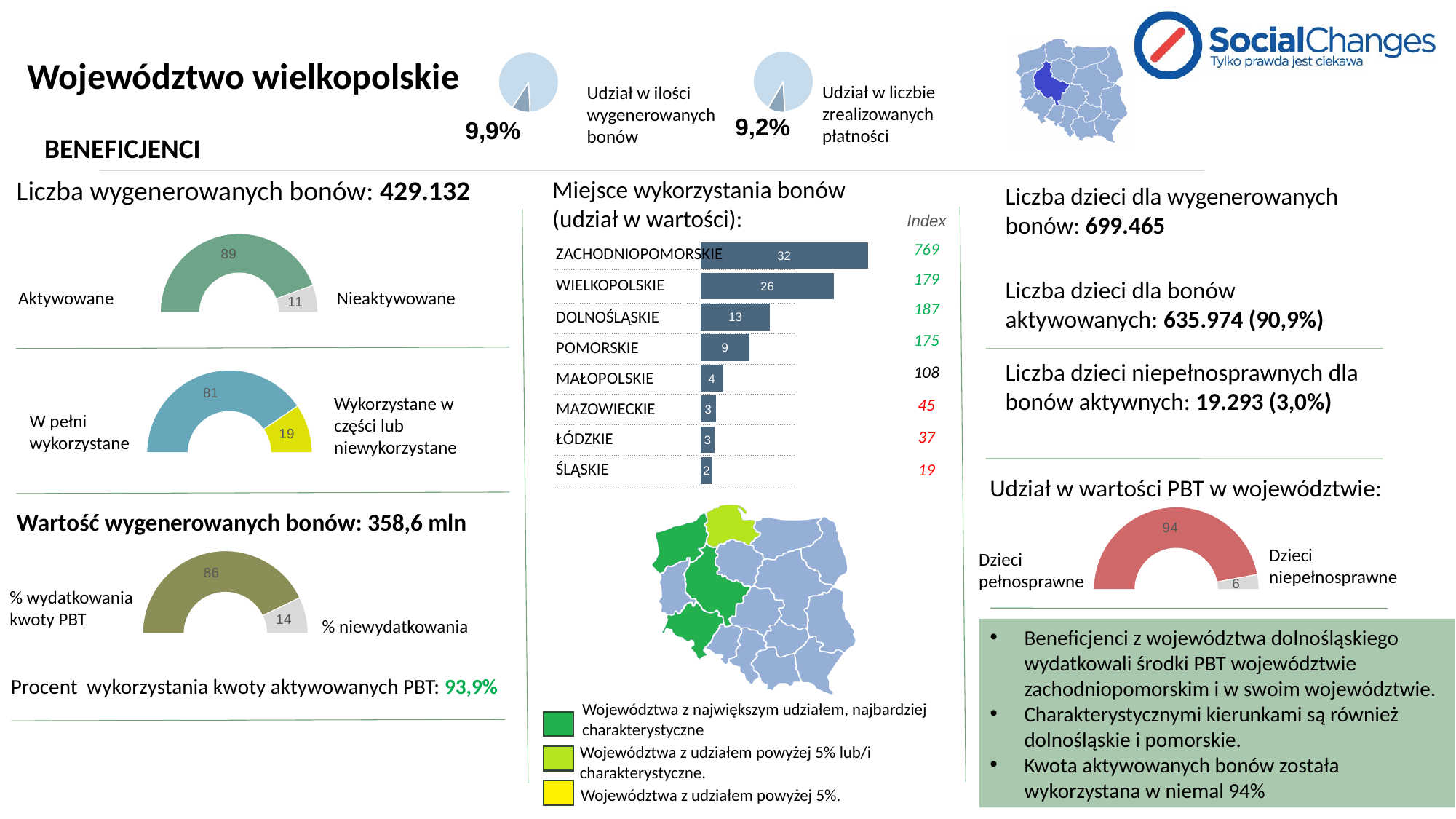
In the 'Miejsce wykorzystania bonów (udział w wartości)' bar chart, how many voivodeships are listed? 8 In the 'Miejsce wykorzystania bonów (udział w wartości)' bar chart, what is the value for WIELKOPOLSKIE? 26 In the half-donut chart with 'W pełni wykorzystane', what is the value for 'Wykorzystane w części lub niewykorzystane'? 19 What kind of chart is 'Miejsce wykorzystania bonów (udział w wartości)'? bar chart In the 'Liczba wygenerowanych bonów' half-donut chart, what is the value for Aktywowane? 89 In the 'Miejsce wykorzystania bonów (udział w wartości)' chart, what is the Index value shown for POMORSKIE? 175 In the 'Udział w wartości PBT w województwie' half-donut chart, what is the value for 'Dzieci niepełnosprawne'? 6 In the 'Miejsce wykorzystania bonów (udział w wartości)' bar chart, which voivodeship has the highest value? ZACHODNIOPOMORSKIE In the 'Miejsce wykorzystania bonów (udział w wartości)' bar chart, which voivodeship has the lowest value? ŚLĄSKIE In the 'Miejsce wykorzystania bonów (udział w wartości)' bar chart, what is the difference between the values for ZACHODNIOPOMORSKIE and DOLNOŚLĄSKIE? 19 In the 'Miejsce wykorzystania bonów (udział w wartości)' chart, which is larger: the value for POMORSKIE or MAŁOPOLSKIE? POMORSKIE In the 'Wartość wygenerowanych bonów' half-donut chart, what is the value for '% niewydatkowania'? 14